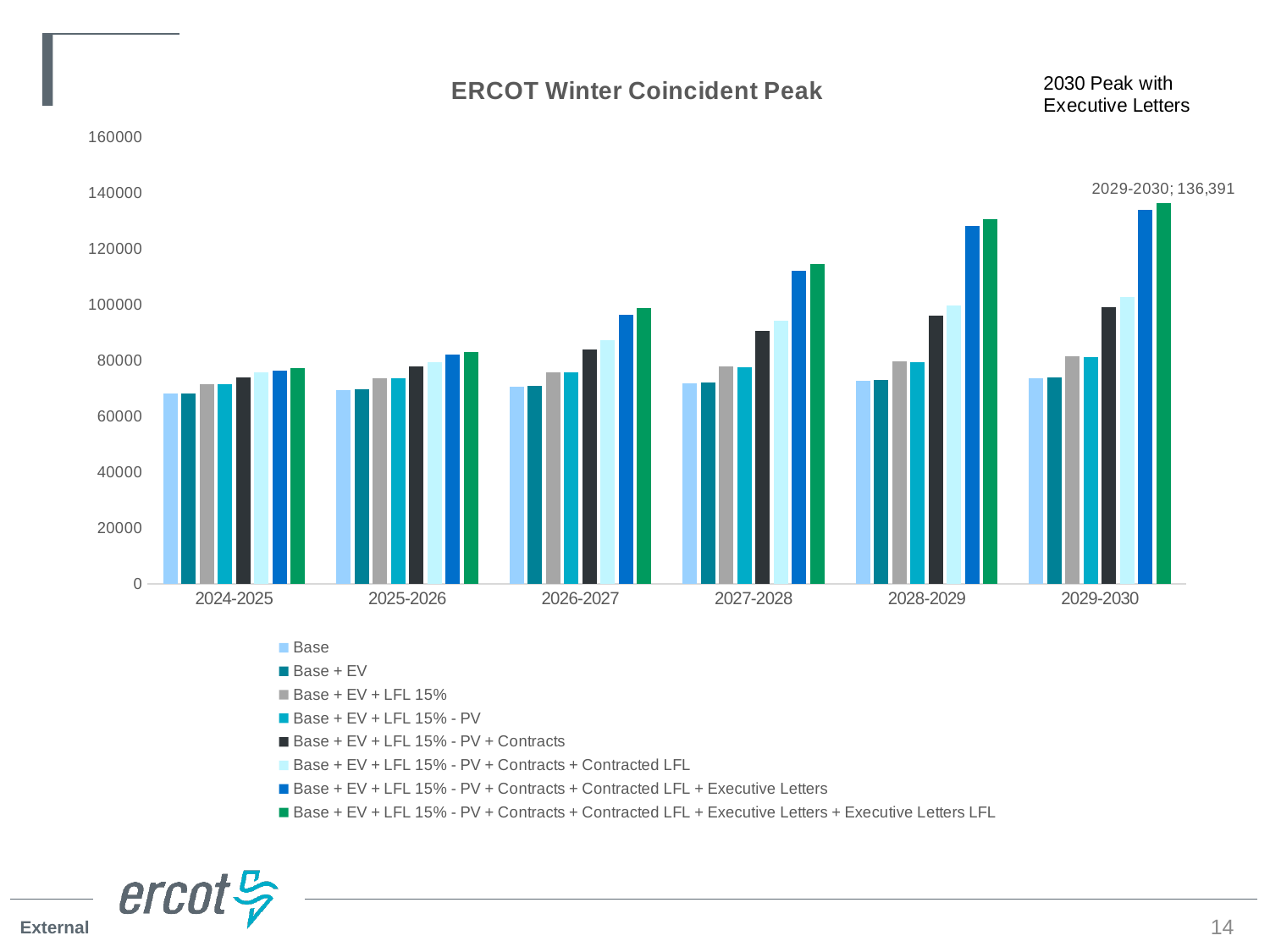
Which season has the lowest value for the 'Base + EV + LFL 15% - PV + Contracts + Contracted LFL + Executive Letters + Executive Letters LFL' series? 2024-2025 Is the Base value for 2024-2025 greater or less than 80000? less Is the value for 2027-2028 in the 'Base + EV + LFL 15% - PV + Contracts + Contracted LFL + Executive Letters' series greater or less than 100000? greater Which season has the highest value for the 'Base + EV + LFL 15% - PV + Contracts + Contracted LFL + Executive Letters + Executive Letters LFL' series? 2029-2030 Do the values for the 'Base + EV + LFL 15% - PV + Contracts + Contracted LFL + Executive Letters + Executive Letters LFL' series rise or fall from 2024-2025 to 2029-2030? rise What is the labeled value for 2029-2030 in the 'Base + EV + LFL 15% - PV + Contracts + Contracted LFL + Executive Letters + Executive Letters LFL' series? 136,391 How many series does the legend list? 8 For 2027-2028, which is larger: the Base value or the 'Base + EV + LFL 15% - PV + Contracts' value? Base + EV + LFL 15% - PV + Contracts What kind of chart is shown on the slide? bar chart What is the title of the chart? ERCOT Winter Coincident Peak How many winter seasons (categories) are shown on the x axis? 6 Is the value for 2028-2029 in the 'Base + EV + LFL 15% - PV + Contracts + Contracted LFL + Executive Letters' series greater or less than 120000? greater